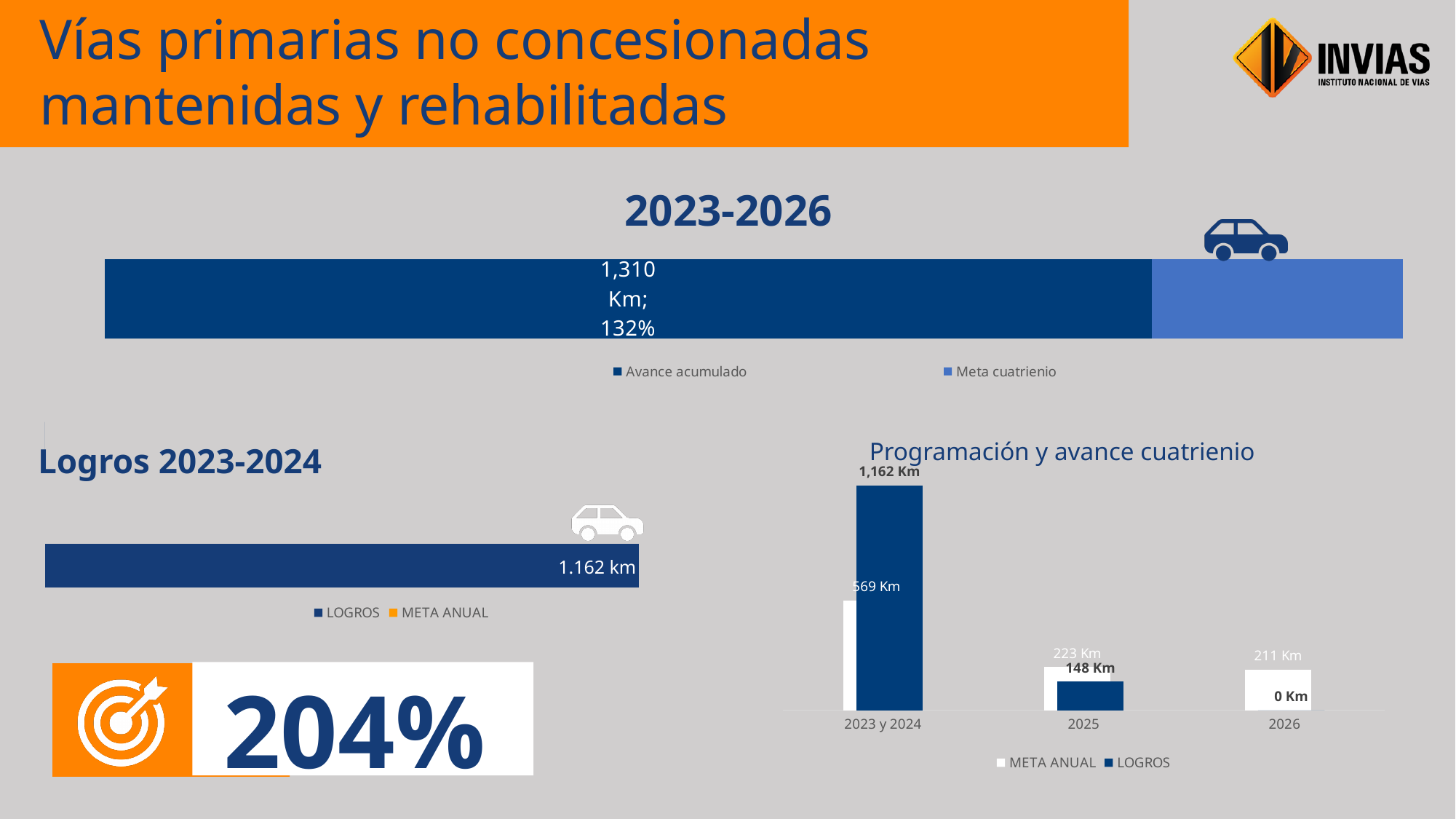
In the 'Programación y avance cuatrienio' chart, what is the META ANUAL value for 2025? 223 Km In the 'Programación y avance cuatrienio' chart, what is the LOGROS value for 2023 y 2024? 1,162 Km In the 'Programación y avance cuatrienio' chart, what is the META ANUAL value for 2023 y 2024? 569 Km How many series does the legend of the 'Programación y avance cuatrienio' chart list? 2 In the 'Programación y avance cuatrienio' chart, which year has the lowest META ANUAL value? 2026 In the 'Programación y avance cuatrienio' chart, what is the LOGROS value for 2026? 0 Km In the '2023-2026' chart at the top, what value is labelled on the Avance acumulado bar? 1,310 Km; 132% In the 'Programación y avance cuatrienio' chart, is the META ANUAL or the LOGROS value larger for 2023 y 2024? LOGROS In the 'Logros 2023-2024' chart, what is the LOGROS value? 1.162 km In the 'Programación y avance cuatrienio' chart, which year has the highest LOGROS value? 2023 y 2024 In the 'Programación y avance cuatrienio' chart, what is the difference between META ANUAL and LOGROS for 2025? 75 Km How many year categories does the 'Programación y avance cuatrienio' chart show? 3